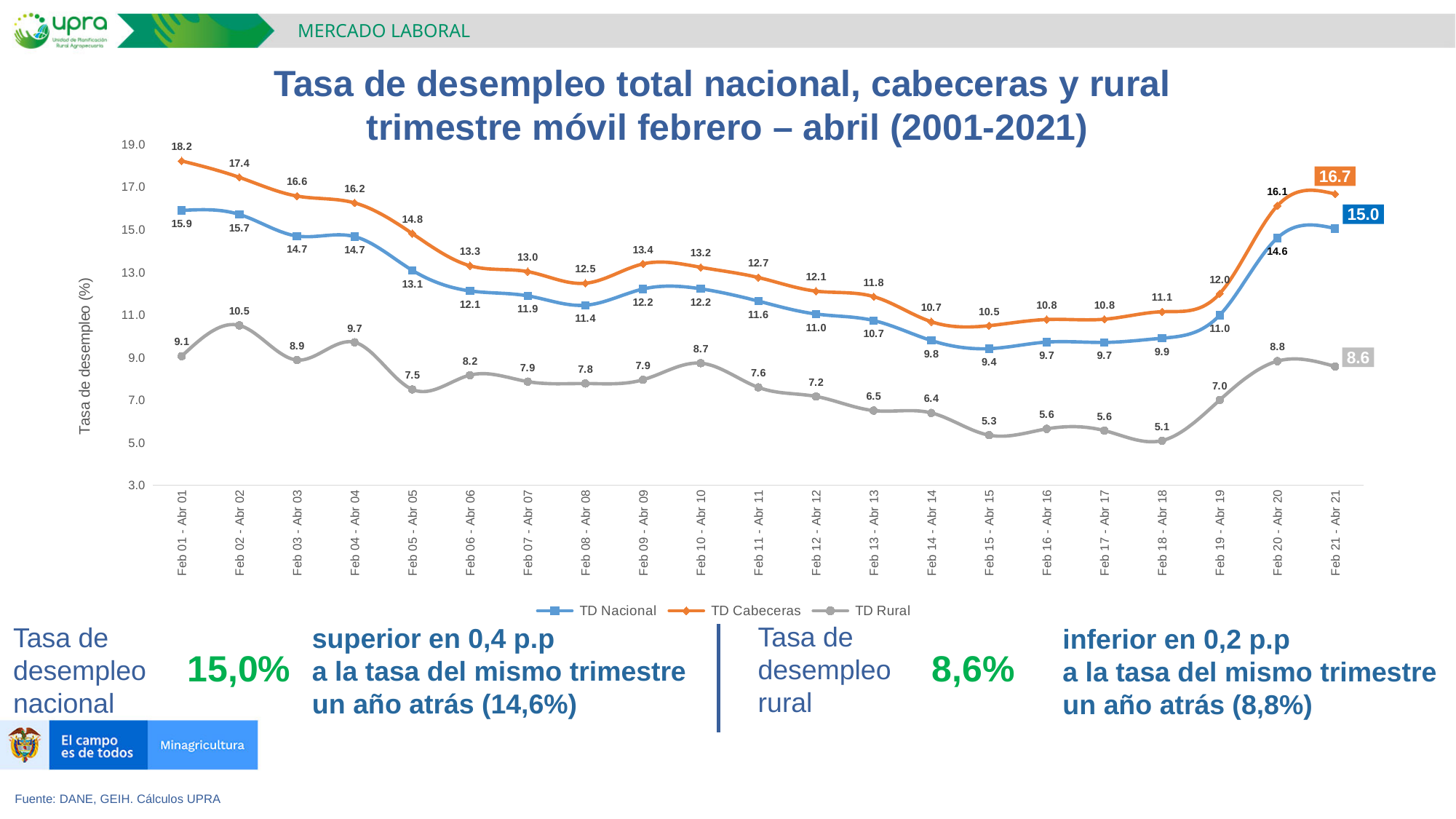
What is the value of TD Nacional for Feb 08 - Abr 08? 11.4 What is the difference between TD Cabeceras and TD Rural in Feb 21 - Abr 21? 8.1 By how much did TD Nacional increase from Feb 20 - Abr 20 to Feb 21 - Abr 21? 0.4 How many periods are shown on the x axis? 21 How many series does the legend list? 3 In which period does TD Cabeceras reach its highest value? Feb 01 - Abr 01 What is the value of TD Cabeceras for Feb 21 - Abr 21? 16.7 What kind of chart is shown on the slide? Line chart What is the value of TD Rural for Feb 15 - Abr 15? 5.3 Which period has a higher TD Rural value, Feb 02 - Abr 02 or Feb 04 - Abr 04? Feb 02 - Abr 02 In which period does TD Rural reach its lowest value? Feb 18 - Abr 18 In which period does TD Nacional reach its lowest value? Feb 15 - Abr 15